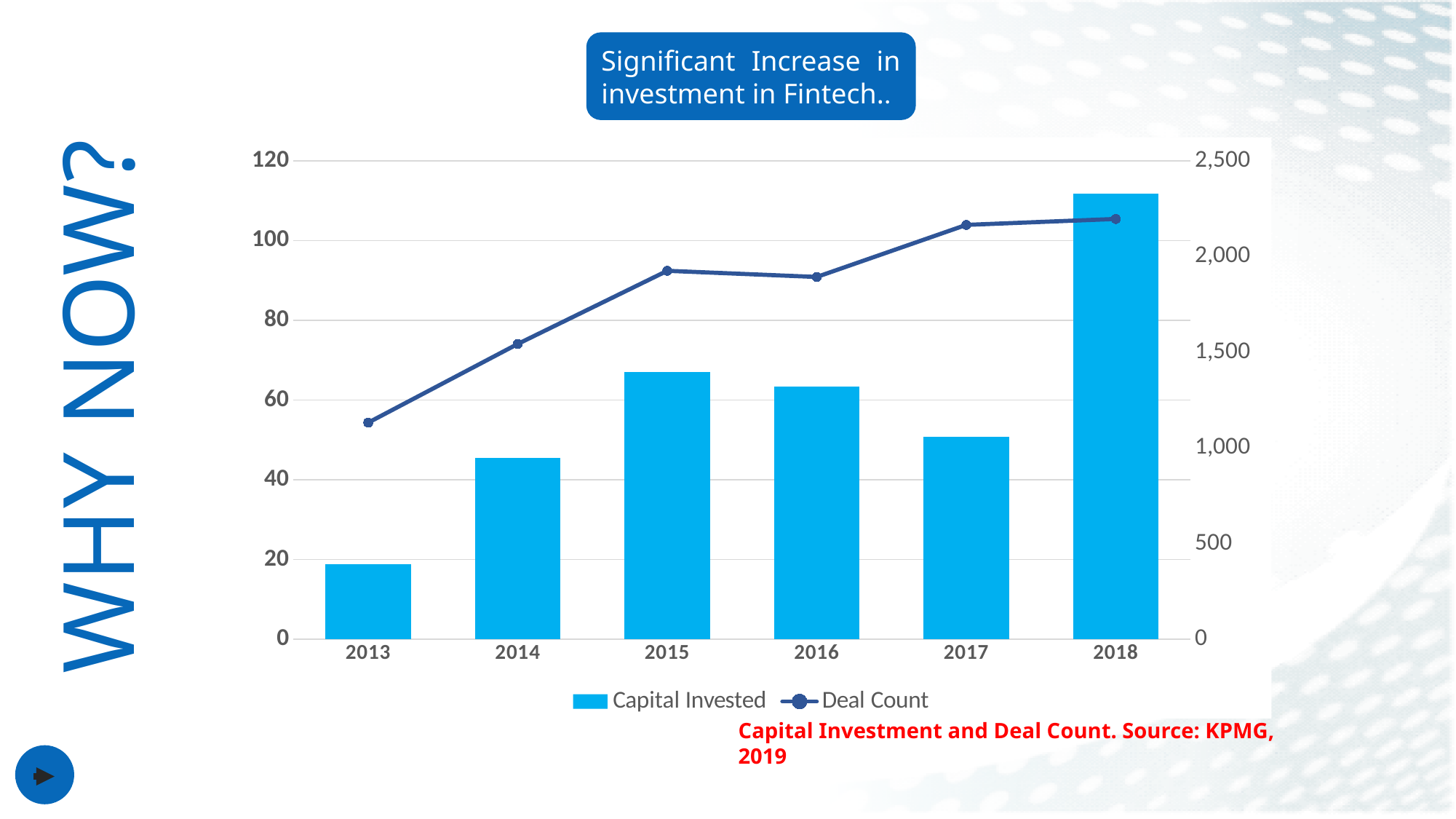
How many series does the legend list? 2 Which year has the larger Capital Invested bar, 2014 or 2017? 2017 Is the Capital Invested value for 2015 greater or less than 60? greater Which year has the shortest Capital Invested bar? 2013 Is the Capital Invested value for 2018 greater or less than 100? greater What are the two series named in the legend? Capital Invested and Deal Count Which year has the tallest Capital Invested bar? 2018 How many years are shown on the x axis? 6 Does the Deal Count line generally rise or fall from 2013 to 2018? rise Is the Deal Count value for 2013 greater or less than 1,500? less